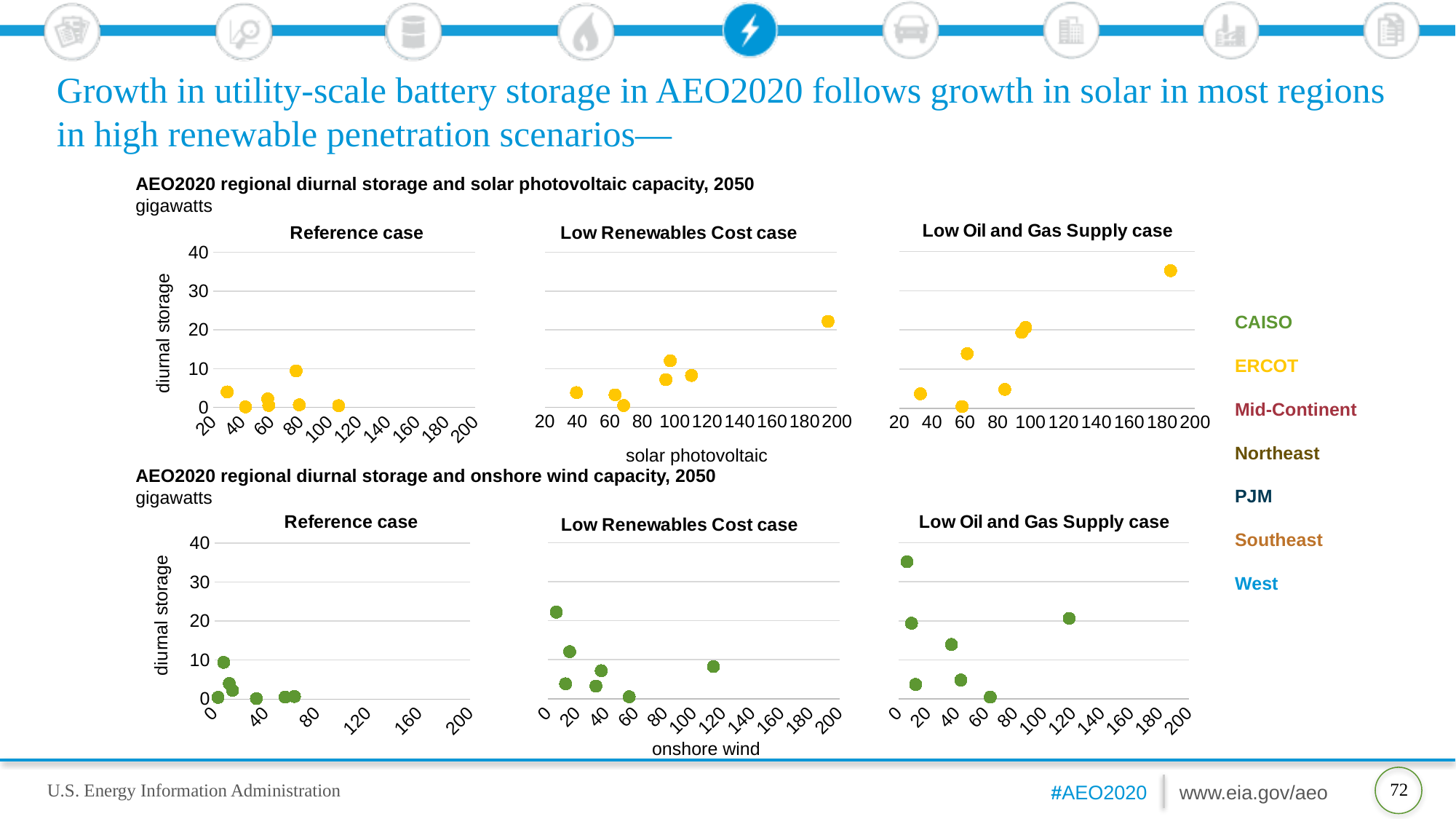
In the top-row Reference case chart, is the highest diurnal storage value greater or less than 20? less In the bottom-row Low Renewables Cost case chart, is the highest diurnal storage value greater or less than 30? less In the top-row Low Renewables Cost case chart, is the highest diurnal storage value greater or less than 20? greater How many regions does the legend on the right list? 7 How many charts are shown on the slide? 6 What kind of chart is the top-row Reference case chart? scatter chart What unit is shown for the charts on the slide? gigawatts What is the title of the top row of charts? AEO2020 regional diurnal storage and solar photovoltaic capacity, 2050 How many points are plotted in the top-row Reference case chart? 7